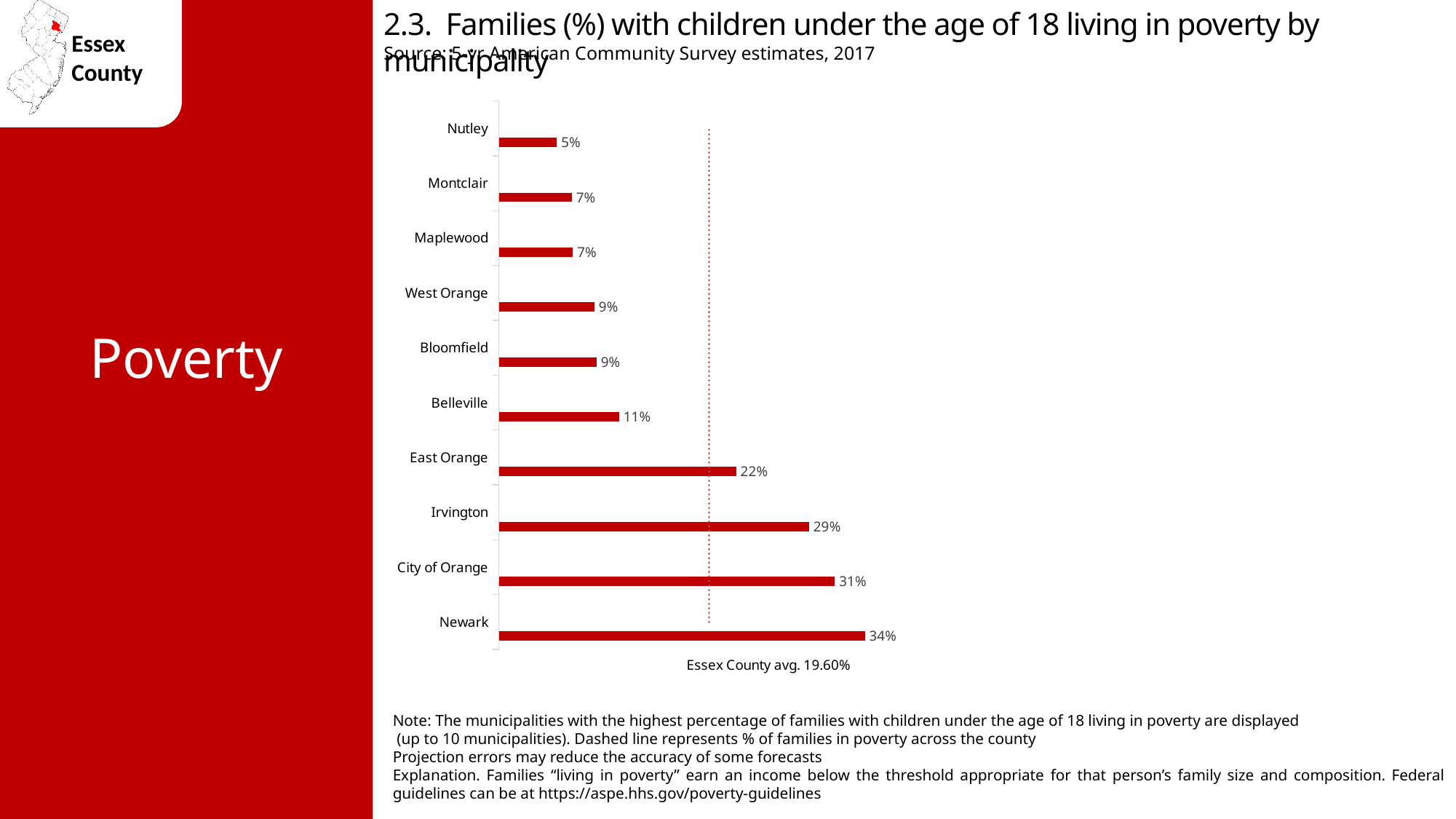
Which municipality has the lowest percentage of families with children under 18 living in poverty? Nutley What percentage of families with children under 18 are living in poverty in Newark? 34% What Essex County average does the dashed line represent? 19.60% What is the value shown for Belleville? 11% What kind of chart is shown on the slide? Bar chart What is the difference between the values for Newark and Nutley? 29% What is the value shown for East Orange? 22% How many municipalities are shown in the chart? 10 Which has a higher value, Irvington or East Orange? Irvington Which municipality has the highest percentage of families with children under 18 living in poverty? Newark Which has a higher value, West Orange or Montclair? West Orange What is the difference between the values for City of Orange and Irvington? 2%